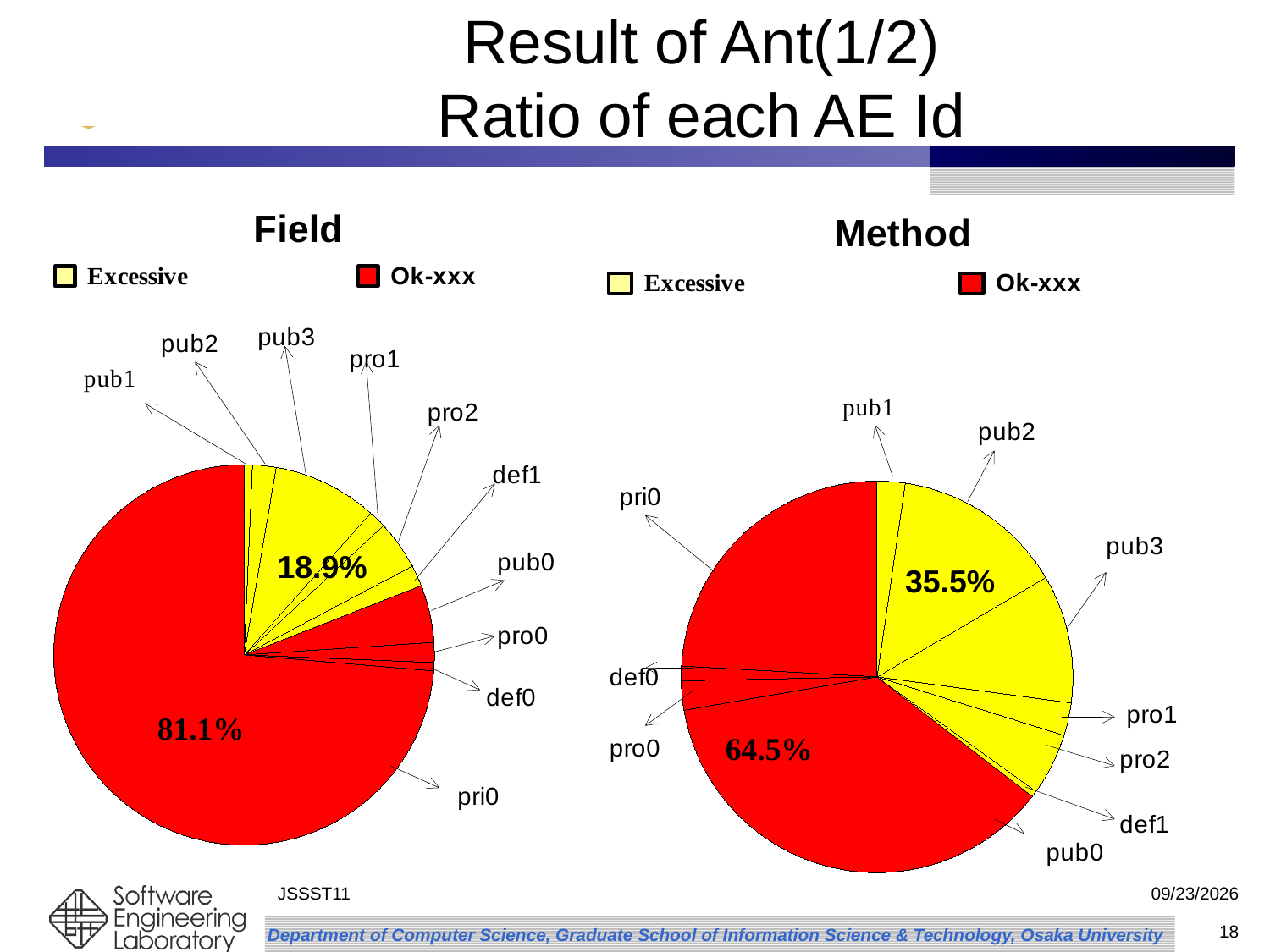
In the Method chart, what percentage is shown for the Ok-xxx (red) portion? 64.5% Which chart has the larger Excessive share, Field or Method? Method What colour represents Ok-xxx in the legends of both charts? Red In the Field chart, what percentage is shown for the Ok-xxx (red) portion? 81.1% How many entries does the legend of the Method chart list? 2 In the Method chart, which portion is larger, Excessive or Ok-xxx? Ok-xxx In the Field chart, what is the difference between the Ok-xxx percentage and the Excessive percentage? 62.2% How many labelled slices does the Field pie chart have? 10 In the Field chart, what percentage is shown for the Excessive (yellow) portion? 18.9% What kind of chart is the Field chart? Pie chart In the Method chart, what percentage is shown for the Excessive (yellow) portion? 35.5% In the Field chart, which portion is the largest? Ok-xxx